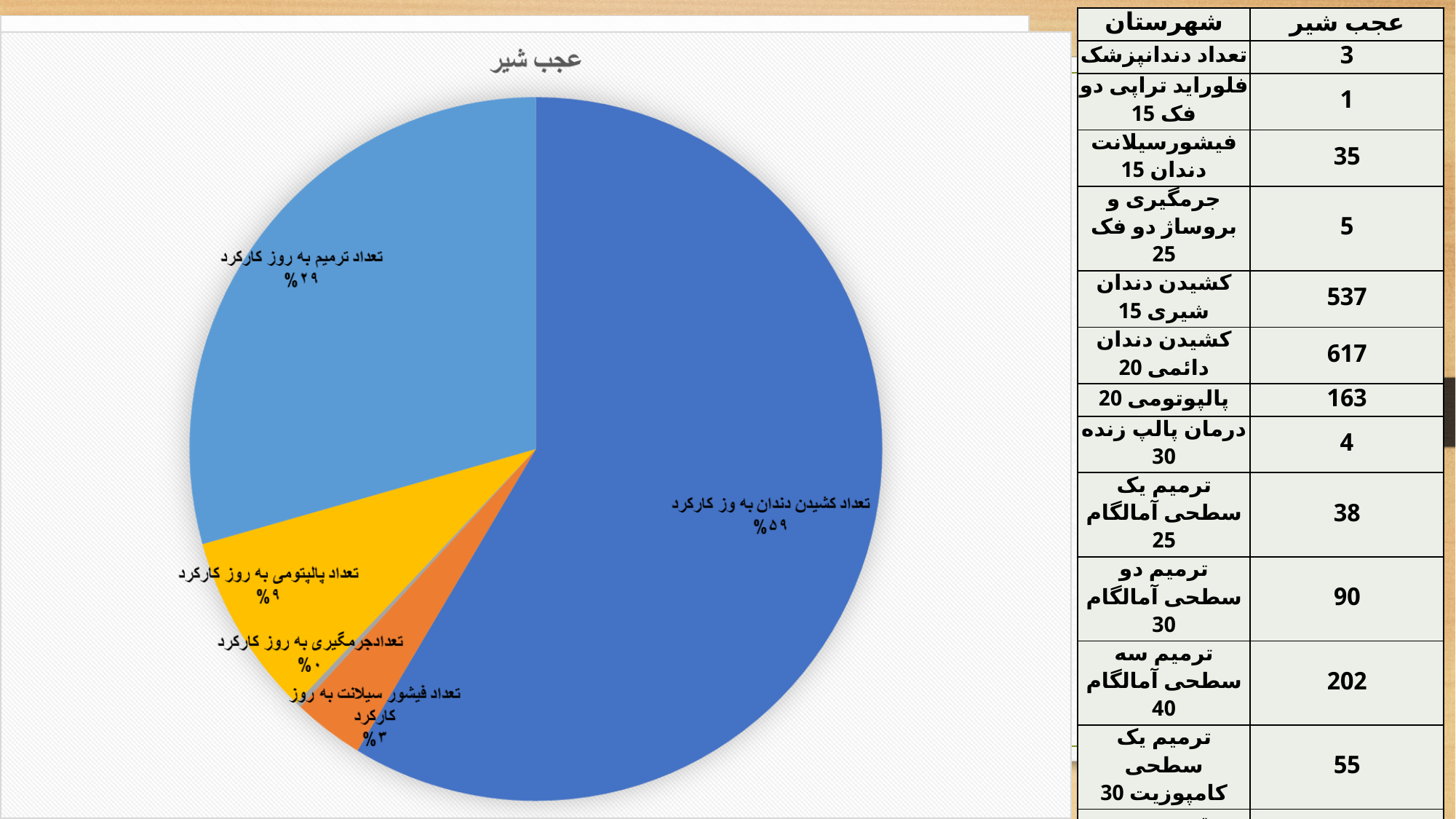
How many slices does the pie chart have? 5 What percentage is shown for the slice تعداد ترمیم به روز کارکرد? ۲۹% Which slice of the pie chart is the largest? تعداد کشیدن دندان به روز کارکرد What percentage is shown for the slice تعداد کشیدن دندان به روز کارکرد? ۵۹% What is the difference in percentage points between the slice تعداد کشیدن دندان به روز کارکرد and the slice تعداد ترمیم به روز کارکرد? ۳۰ What is the title of the pie chart? عجب شیر Which slice of the pie chart is the smallest? تعداد جرمگیری به روز کارکرد Which is larger: the slice for تعداد ترمیم به روز کارکرد or the slice for تعداد پالپتومی به روز کارکرد? تعداد ترمیم به روز کارکرد What percentage is shown for the slice تعداد جرمگیری به روز کارکرد? ۰% What percentage is shown for the slice تعداد فیشور سیلانت به روز کارکرد? ۳% What kind of chart is shown on the slide? pie chart What percentage is shown for the slice تعداد پالپتومی به روز کارکرد? ۹%